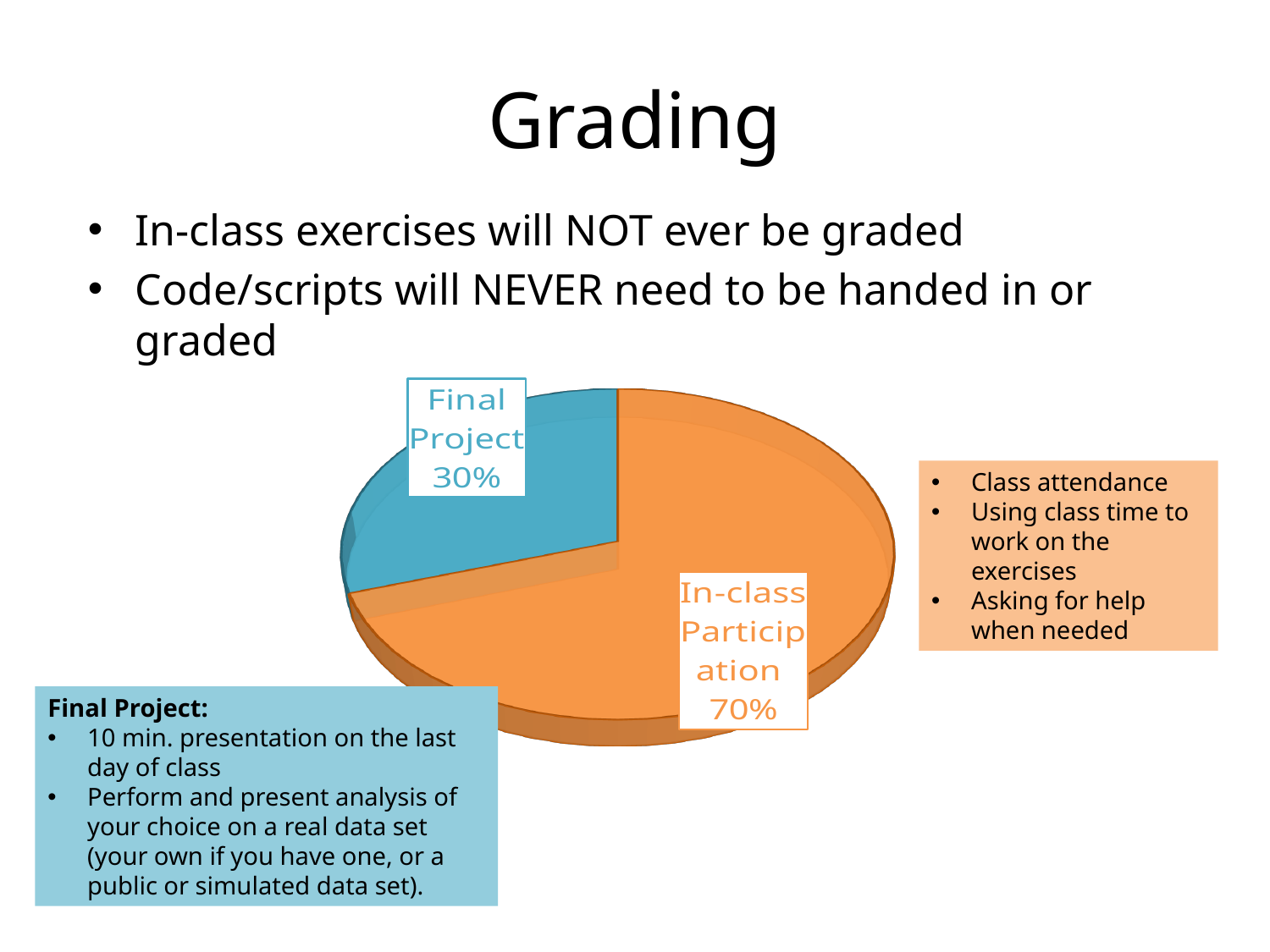
What share of the pie does In-class Participation represent? 70% Which slice of the pie is the smallest? Final Project What kind of chart is shown on the slide? pie chart How many slices does the pie chart have? 2 Which is larger, the Final Project slice or the In-class Participation slice? In-class Participation What colour is the In-class Participation slice? orange What colour is the Final Project slice? blue What share of the pie does Final Project represent? 30% Is the share for Final Project greater or less than 50%? less What is the difference in percentage points between In-class Participation and Final Project? 40 Which slice of the pie is the largest? In-class Participation